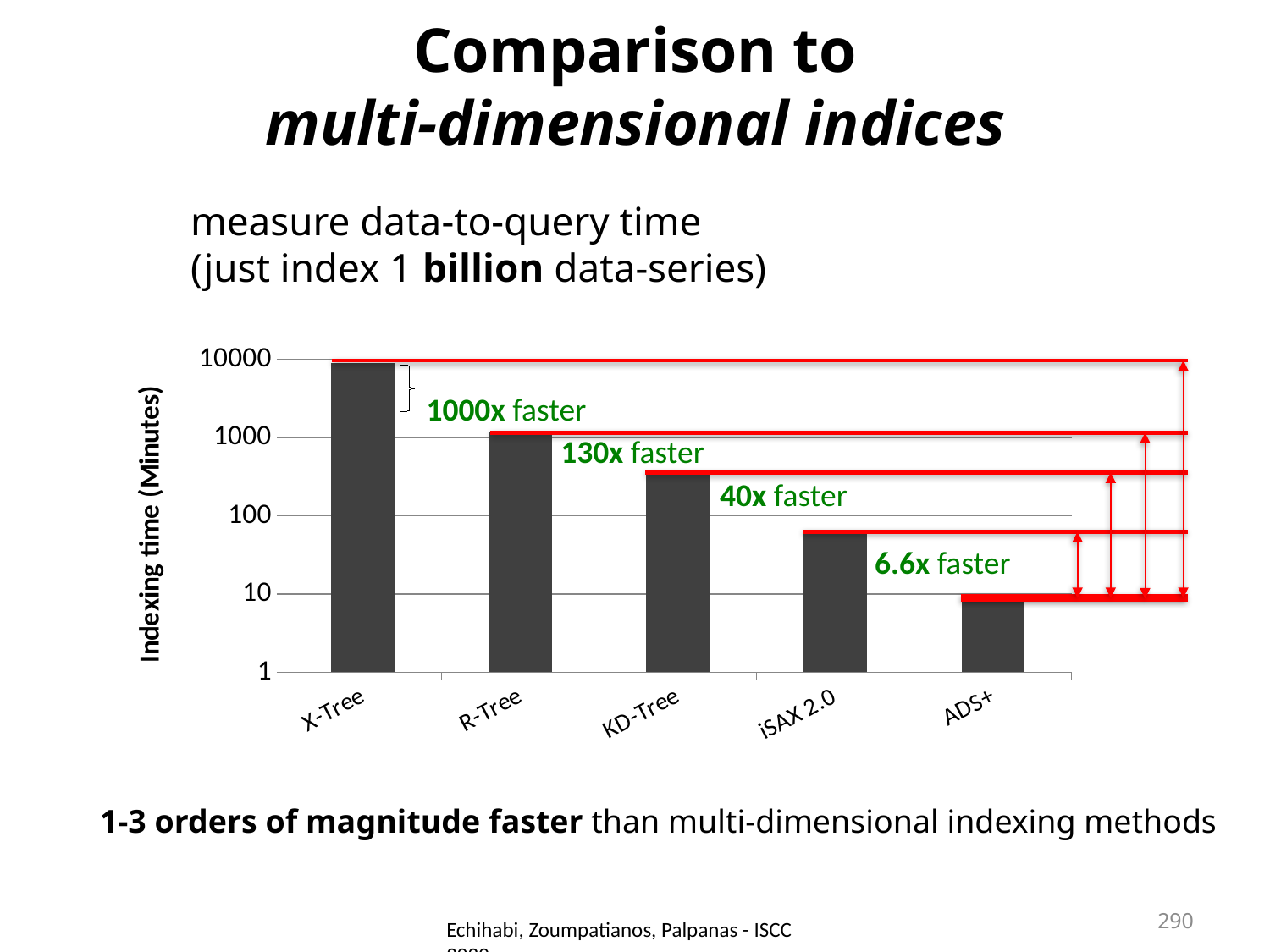
Is the indexing time for KD-Tree greater or less than 100 minutes? greater Which indexing method has the highest indexing time? X-Tree Which has a larger indexing time, KD-Tree or iSAX 2.0? KD-Tree What is the label of the y axis? Indexing time (Minutes) According to the annotation on the chart, how many times faster is ADS+ than iSAX 2.0? 6.6x Is the indexing time for iSAX 2.0 greater or less than 100 minutes? less Do the indexing times rise or fall from X-Tree to ADS+ along the x axis? fall Is the indexing time for X-Tree greater or less than 1000 minutes? greater Which indexing method has the lowest indexing time? ADS+ How many indexing methods are plotted on the x axis? 5 What kind of chart is shown on the slide? bar chart